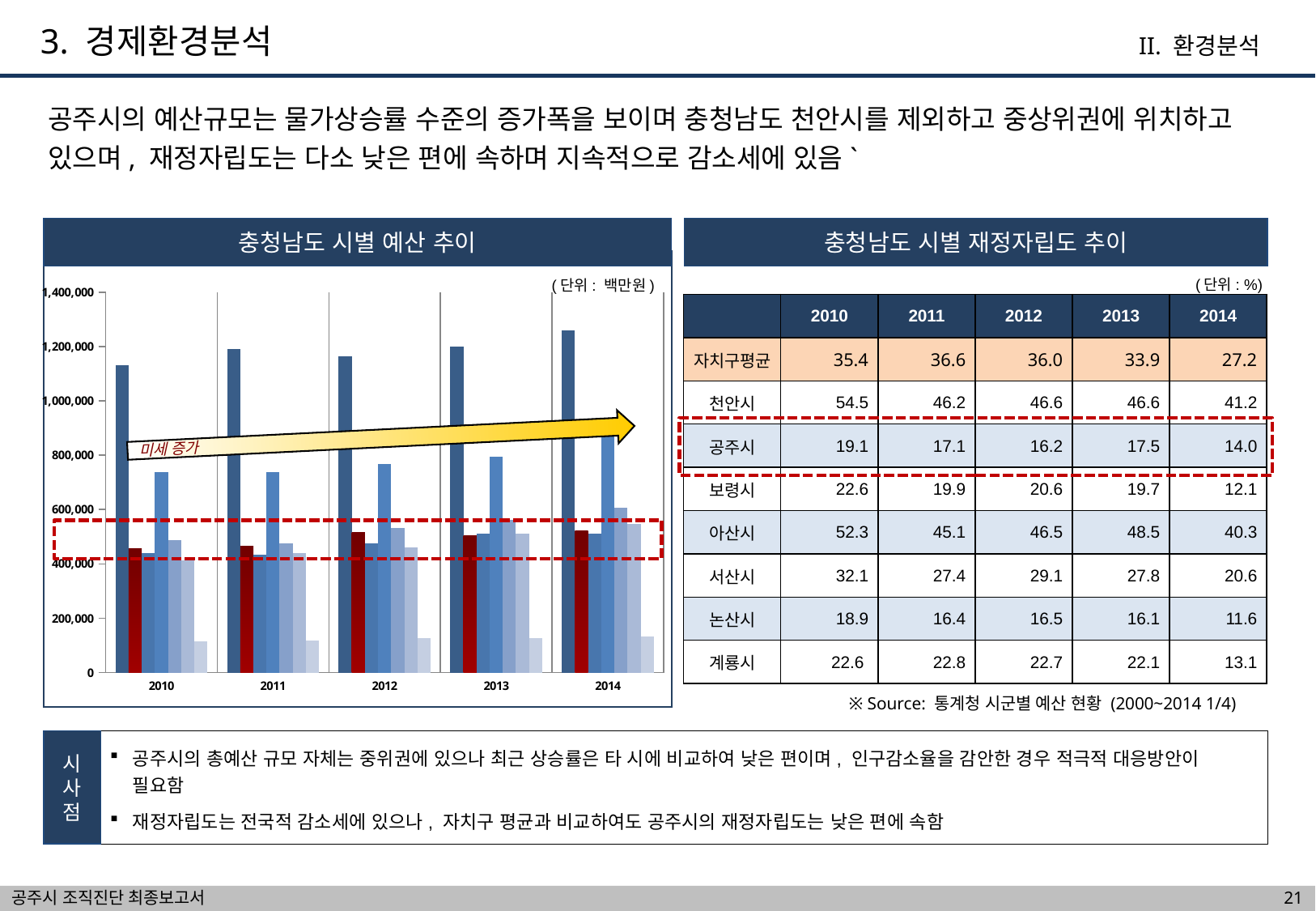
In the 충청남도 시별 예산 추이 chart, is the tallest bar in the 2014 group taller or shorter than the tallest bar in the 2010 group? taller In the 충청남도 시별 예산 추이 chart, is the tallest bar in the 2013 group greater or less than 1,000,000? greater How many year categories are shown on the x axis of the 충청남도 시별 예산 추이 chart? 5 What is the title of the bar chart on the left of the slide? 충청남도 시별 예산 추이 In the 충청남도 시별 예산 추이 chart, does the tallest bar in each year group generally rise or fall from 2010 to 2014? rise In the 충청남도 시별 예산 추이 chart, is the shortest bar in the 2010 group greater or less than 200,000? less In the 충청남도 시별 예산 추이 chart, is the tallest bar in the 2010 group greater or less than 1,200,000? less What unit is stated for the values in the 충청남도 시별 예산 추이 chart? 백만원 In the 충청남도 시별 예산 추이 chart, which year group contains the tallest bar overall? 2014 What kind of chart is shown under the title 충청남도 시별 예산 추이? bar chart